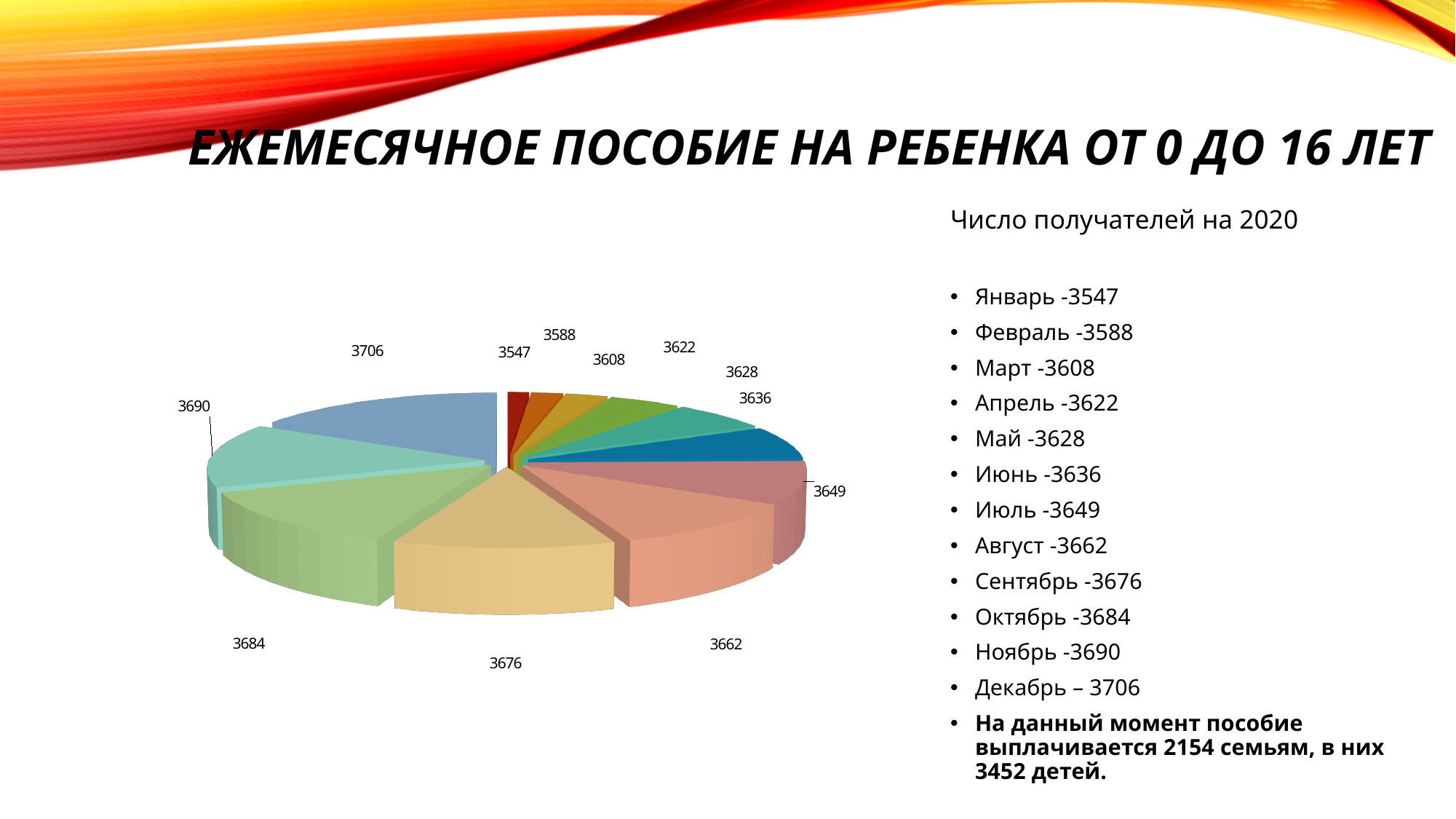
What is the smallest value printed as a data label on the pie chart? 3547 Do the recipient values rise or fall from Январь to Декабрь? rise What kind of chart is shown on the slide? pie chart What is the number of recipients for Июль (July) shown on the slide? 3649 How many slices does the pie chart have? 12 According to the slide, which month has the lowest number of recipients in 2020? Январь What is the difference between the recipients in Ноябрь (3690) and Октябрь (3684)? 6 What is the number of recipients for Сентябрь (September) shown on the slide? 3676 What is the largest value printed as a data label on the pie chart? 3706 According to the slide, which month has the highest number of recipients (Число получателей) in 2020? Декабрь What is the difference between the largest data label (3706) and the smallest data label (3547) on the pie chart? 159 Which is larger, the value for Март (March) or the value for Май (May)? Май